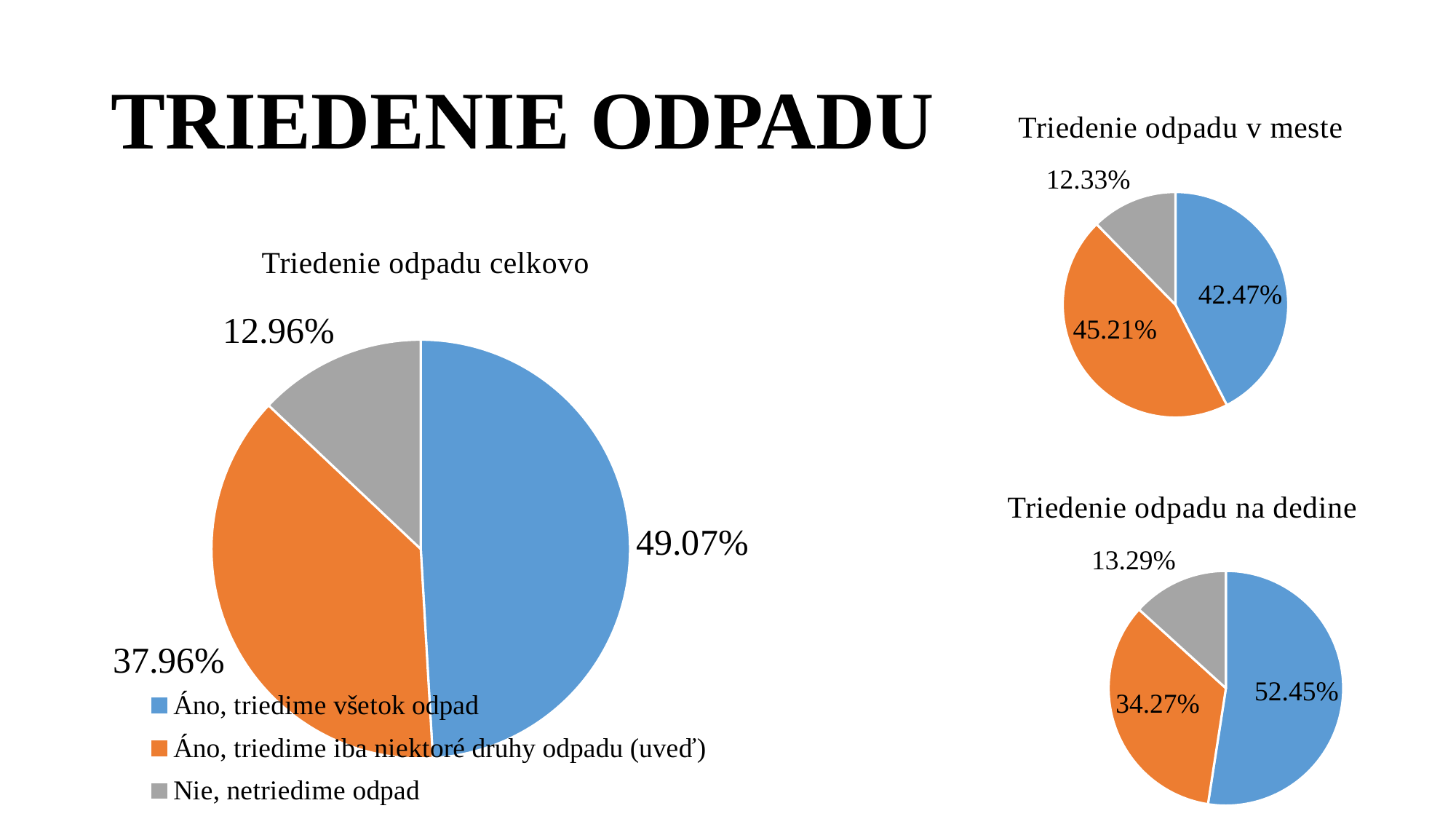
In the chart titled "Triedenie odpadu v meste", what share is shown for the orange slice ("Áno, triedime iba niektoré druhy odpadu (uveď)")? 45.21% In the chart titled "Triedenie odpadu v meste", which is larger: the blue slice or the orange slice? the orange slice How many entries does the legend of the chart titled "Triedenie odpadu celkovo" list? 3 In the chart titled "Triedenie odpadu celkovo", what share is shown for "Nie, netriedime odpad"? 12.96% In the chart titled "Triedenie odpadu na dedine", what share is shown for the grey slice ("Nie, netriedime odpad")? 13.29% In the chart titled "Triedenie odpadu celkovo", which category has the largest slice? Áno, triedime všetok odpad In the chart titled "Triedenie odpadu na dedine", what is the difference between the blue slice (52.45%) and the orange slice (34.27%)? 18.18% In the chart titled "Triedenie odpadu celkovo", what share is shown for "Áno, triedime všetok odpad"? 49.07% In the chart titled "Triedenie odpadu na dedine", what share is shown for the blue slice ("Áno, triedime všetok odpad")? 52.45% What kind of chart is "Triedenie odpadu celkovo"? pie chart How many slices does the chart titled "Triedenie odpadu celkovo" have? 3 In the chart titled "Triedenie odpadu celkovo", which category has the smallest slice? Nie, netriedime odpad